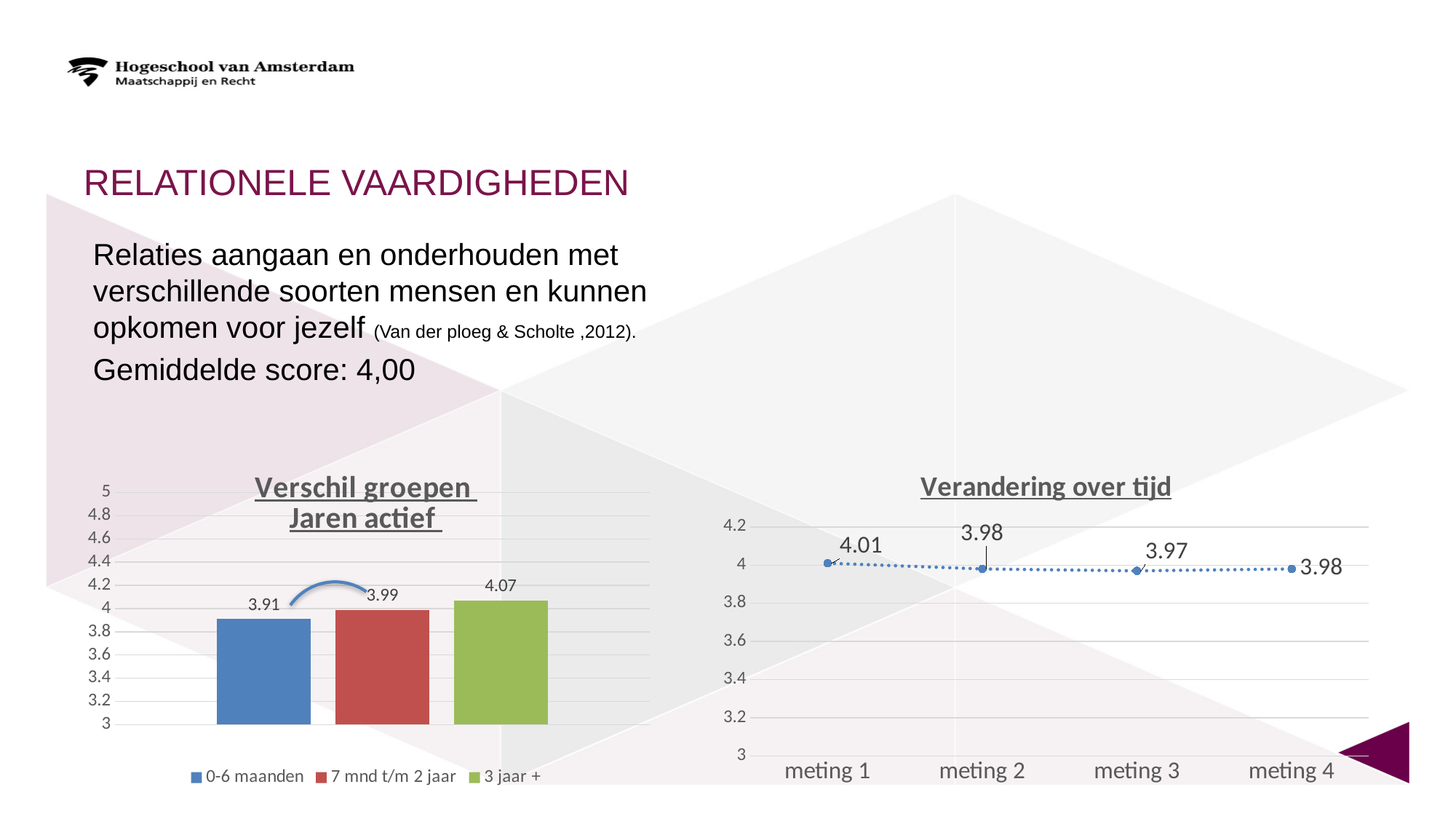
In the 'Verschil groepen Jaren actief' chart, what is the difference between the values for '3 jaar +' and '0-6 maanden'? 0.16 In the 'Verschil groepen Jaren actief' chart, what is the value for '3 jaar +'? 4.07 What kind of chart is 'Verandering over tijd'? line chart In the 'Verandering over tijd' chart, what is the value at meting 1? 4.01 In the 'Verandering over tijd' chart, what is the value at meting 3? 3.97 What kind of chart is 'Verschil groepen Jaren actief'? bar chart In the 'Verschil groepen Jaren actief' chart, which group has the lowest value? 0-6 maanden In the 'Verschil groepen Jaren actief' chart, what is the value for '0-6 maanden'? 3.91 In the 'Verschil groepen Jaren actief' chart, which group has the highest value? 3 jaar + In the 'Verandering over tijd' chart, what is the difference between the values at meting 1 and meting 3? 0.04 In the 'Verandering over tijd' chart, how many measurement points are plotted? 4 In the 'Verschil groepen Jaren actief' chart, how many entries does the legend list? 3